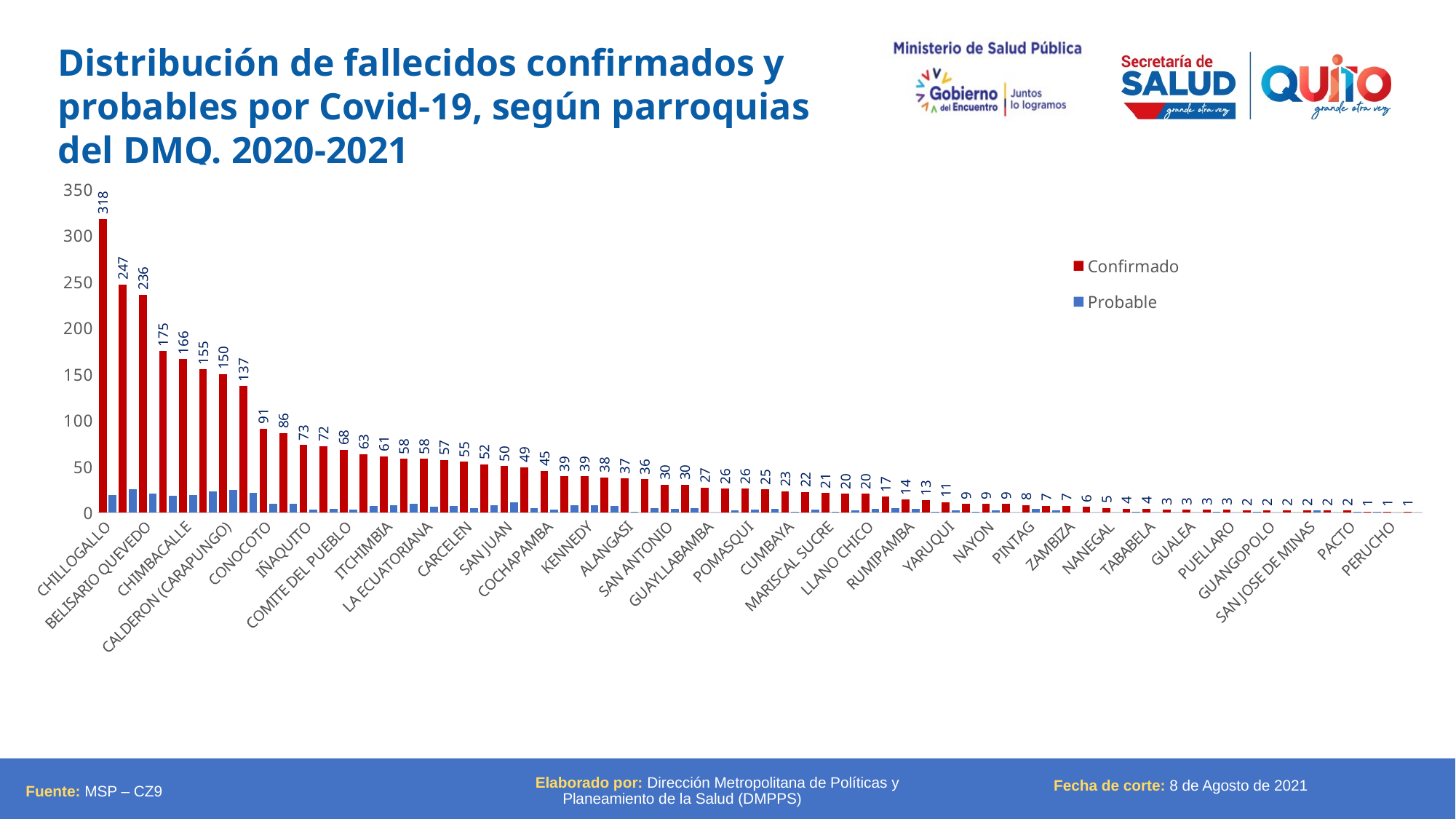
What is the confirmed death count for CHILLOGALLO? 318 Which parish has the highest number of confirmed deaths? CHILLOGALLO How many series does the legend list? 2 What is the difference in confirmed deaths between CHILLOGALLO (318) and CONOCOTO (91)? 227 What is the name of the second series listed in the legend? Probable Which has more confirmed deaths, CHILLOGALLO or CHIMBACALLE? CHILLOGALLO Do the confirmed death values rise or fall moving from left to right along the x axis? fall Which colour represents the 'Confirmado' series in the legend? red What type of chart is shown on the slide? bar chart What is the confirmed death count for PERUCHO? 1 What is the confirmed death count for CONOCOTO? 91 Is the confirmed value for CHILLOGALLO greater or less than 300? greater